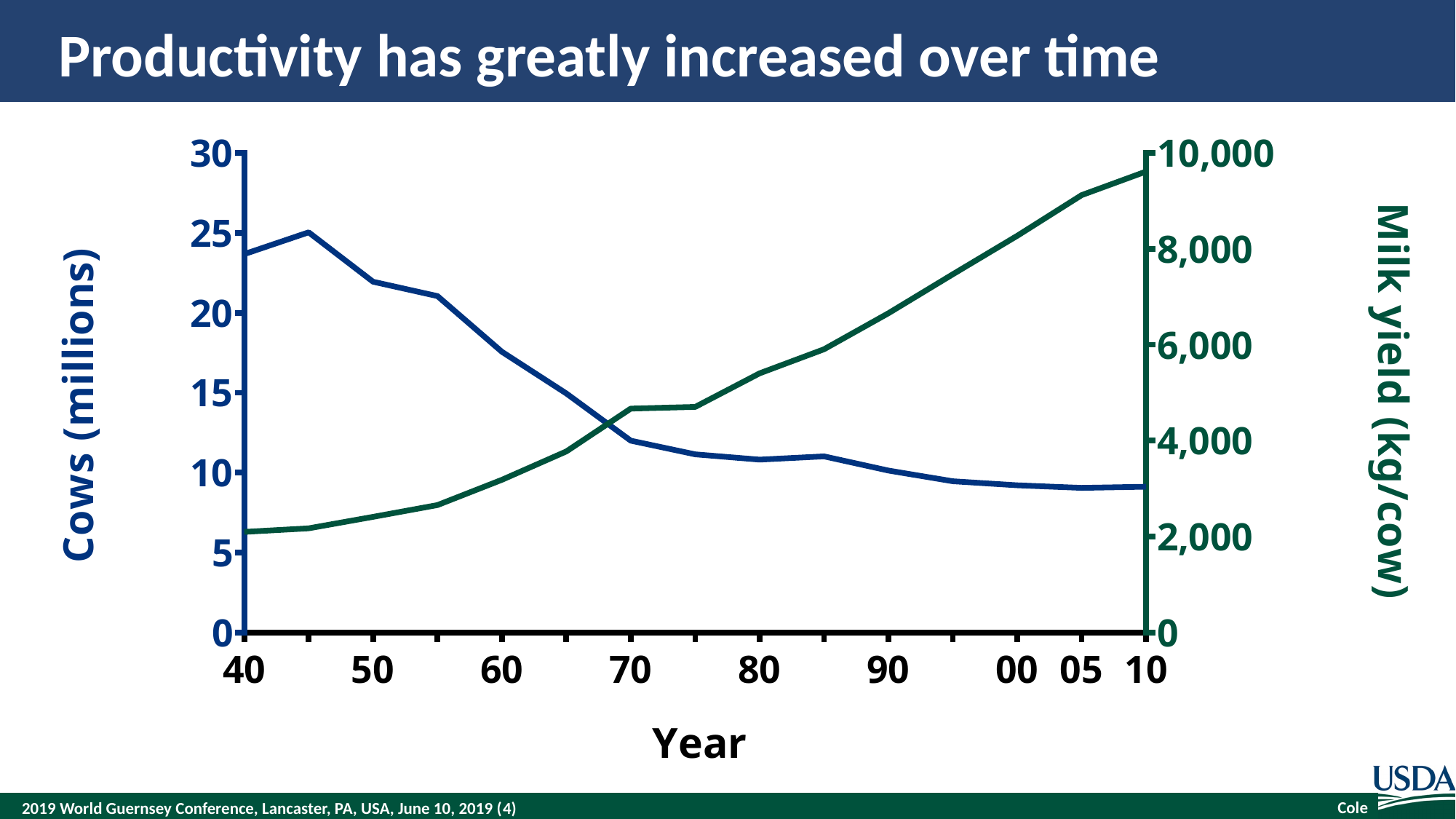
Is the value for Milk yield (kg/cow) at year 70 greater or less than 6,000? less Is the value for Cows (millions) at year 10 greater or less than 10? less Is the value for Cows (millions) at year 40 greater or less than 20? greater In which year is Milk yield (kg/cow) highest? 10 How many data series (lines) are plotted on the chart? 2 Which year has the larger value for Cows (millions), 50 or 60? 50 What kind of chart is shown on the slide? line chart Does the Milk yield (kg/cow) line rise or fall from year 40 to year 10? rise What is the label of the right-hand vertical axis? Milk yield (kg/cow) Does the Cows (millions) line rise or fall from year 40 to year 10? fall